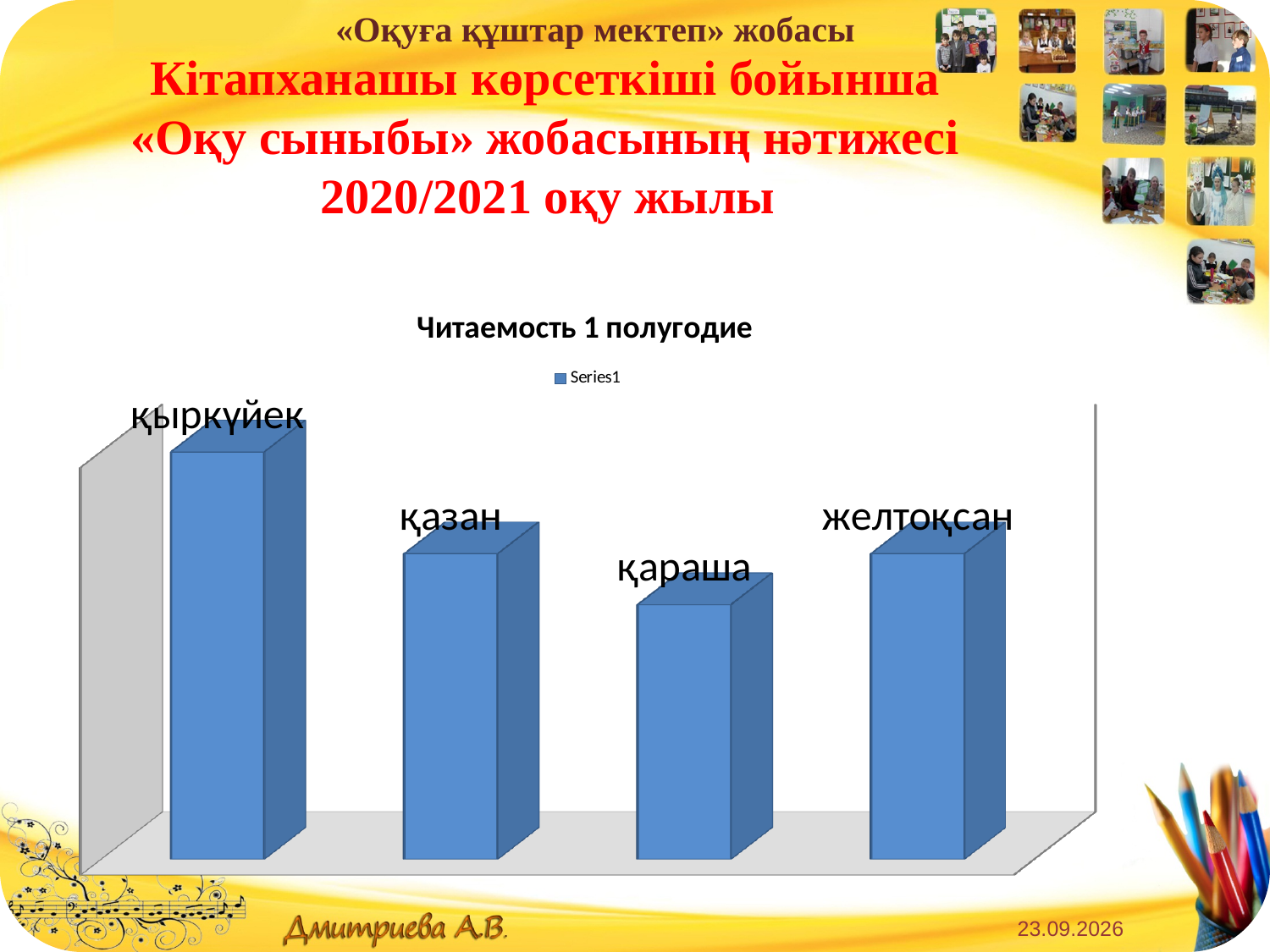
What is the title of the chart? Читаемость 1 полугодие Which is larger, the value for қыркүйек or the value for қараша? қыркүйек Which is larger, the value for қараша or the value for желтоқсан? желтоқсан Which is larger, the value for қыркүйек or the value for қазан? қыркүйек What kind of chart is shown on the slide? bar chart What is the name of the series shown in the legend? Series1 Which category has the highest bar? қыркүйек How many categories (bars) does the chart show? 4 Do the values rise or fall from қыркүйек to қараша? fall How many series does the legend list? 1 Which category is the first bar on the left of the chart? қыркүйек Which category has the lowest bar? қараша